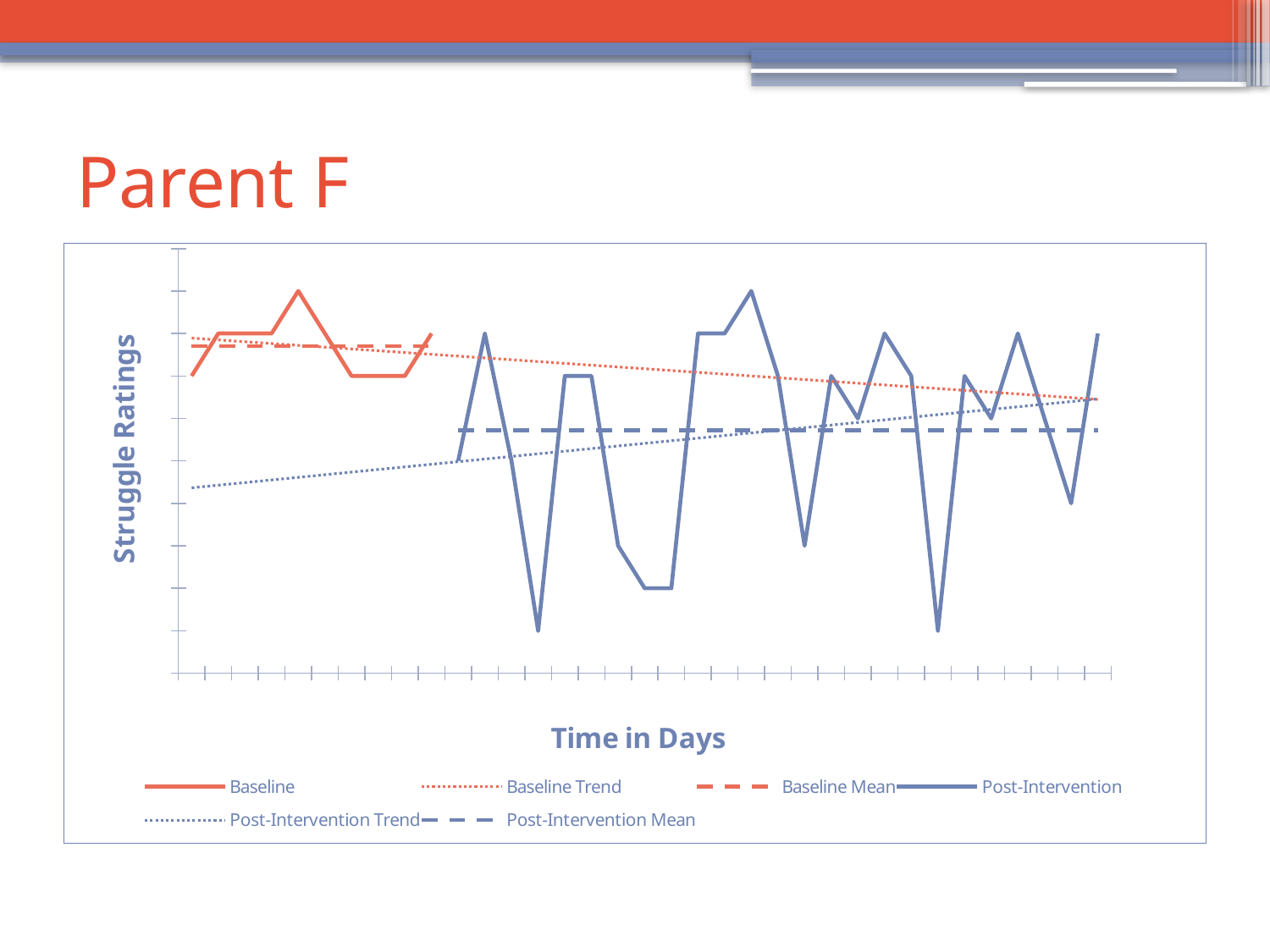
What kind of chart is shown on the slide? line chart Which is higher on the chart, the Baseline Mean line or the Post-Intervention Mean line? Baseline Mean What is the title of the x axis? Time in Days Does the Baseline Trend line rise or fall along the x axis? fall What is the title of the y axis? Struggle Ratings How many series does the legend list? 6 Does the Post-Intervention Trend line rise or fall along the x axis? rise Which series reaches the lowest point on the chart, Baseline or Post-Intervention? Post-Intervention